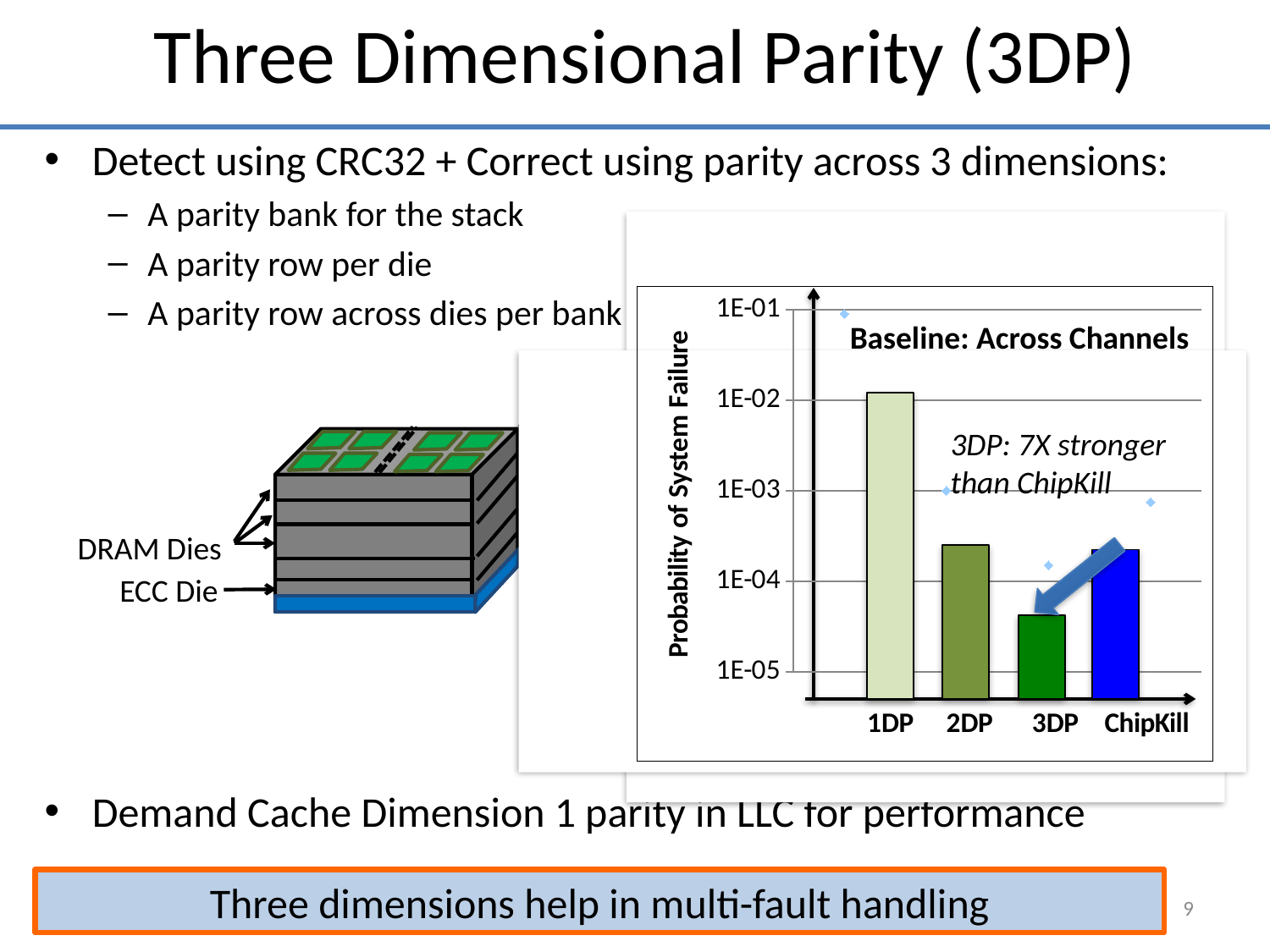
Which category has the highest probability of system failure in the chart? 1DP Is the value for 2DP greater or less than 1E-03? less Is the value for ChipKill greater or less than 1E-04? greater How many categories are plotted on the x axis of the chart? 4 Is the value for 1DP greater or less than 1E-03? greater What is the label on the y axis of the chart? Probability of System Failure According to the annotation on the chart, how many times stronger is 3DP than ChipKill? 7X Do the bar values rise or fall going from 1DP to 3DP along the x axis? fall Which has a higher probability of system failure, 3DP or ChipKill? ChipKill Which category has the lowest probability of system failure in the chart? 3DP What kind of chart is shown on the slide? bar chart